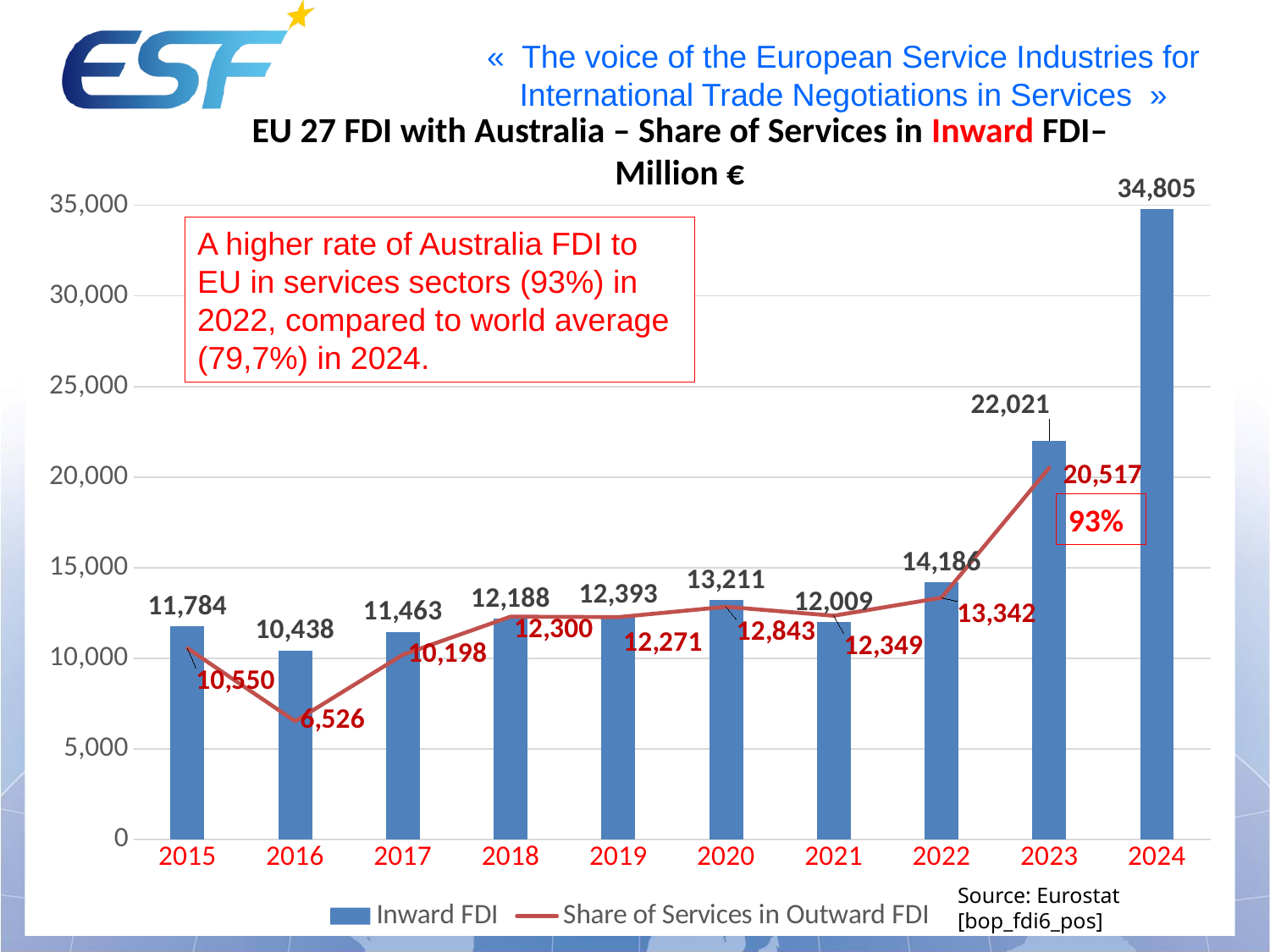
What kind of chart is shown on the slide? A combination bar and line chart What is the difference between the Inward FDI bar and the Share of Services line value in 2023? 1,504 What is the difference between the Inward FDI values for 2024 and 2023? 12,784 What is the value of the Share of Services in Outward FDI line for 2023? 20,517 What is the Inward FDI value for 2016? 10,438 Which year has the lowest Inward FDI? 2016 How many series does the legend list? 2 What is the Inward FDI value for 2024? 34,805 Which year has the highest Inward FDI? 2024 What is the value of the Share of Services in Outward FDI line for 2016? 6,526 Which year has the larger Inward FDI, 2020 or 2021? 2020 How many years are shown on the x axis? 10